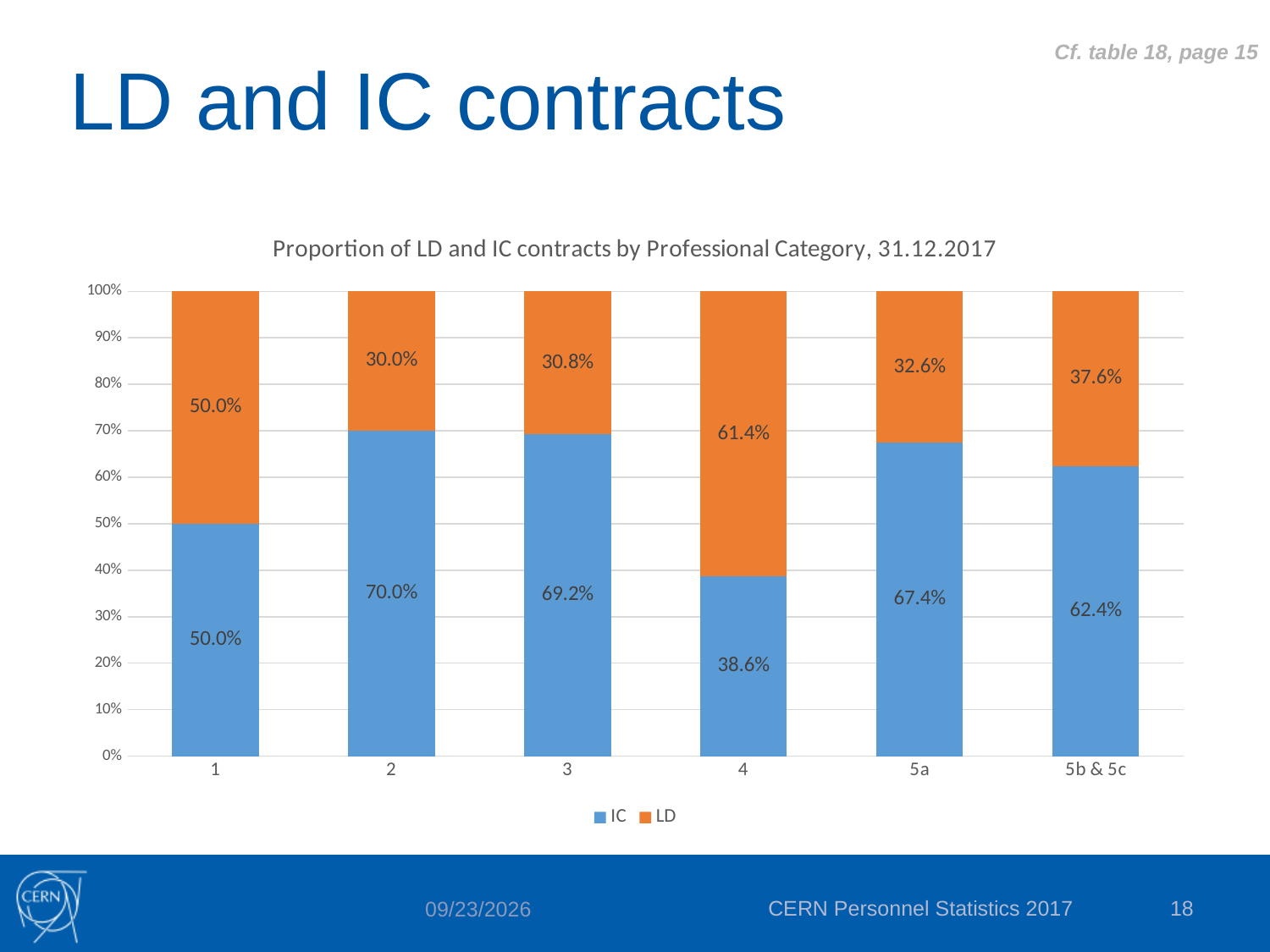
What is the title of the chart? Proportion of LD and IC contracts by Professional Category, 31.12.2017 What kind of chart is shown on the slide? Stacked bar chart Which professional category has the lowest IC share? 4 Which professional category has the highest IC share? 2 How many series does the legend list? 2 What is the difference between the IC share and the LD share for category 4? 22.8% How many professional categories are shown on the x axis? 6 What is the IC share for professional category 2? 70.0% What is the LD share for professional category 4? 61.4% Which is larger, the LD share for category 5a or the LD share for category 5b & 5c? 5b & 5c Is the IC share for category 3 greater or less than 60%? greater What is the IC share for category 5b & 5c? 62.4%